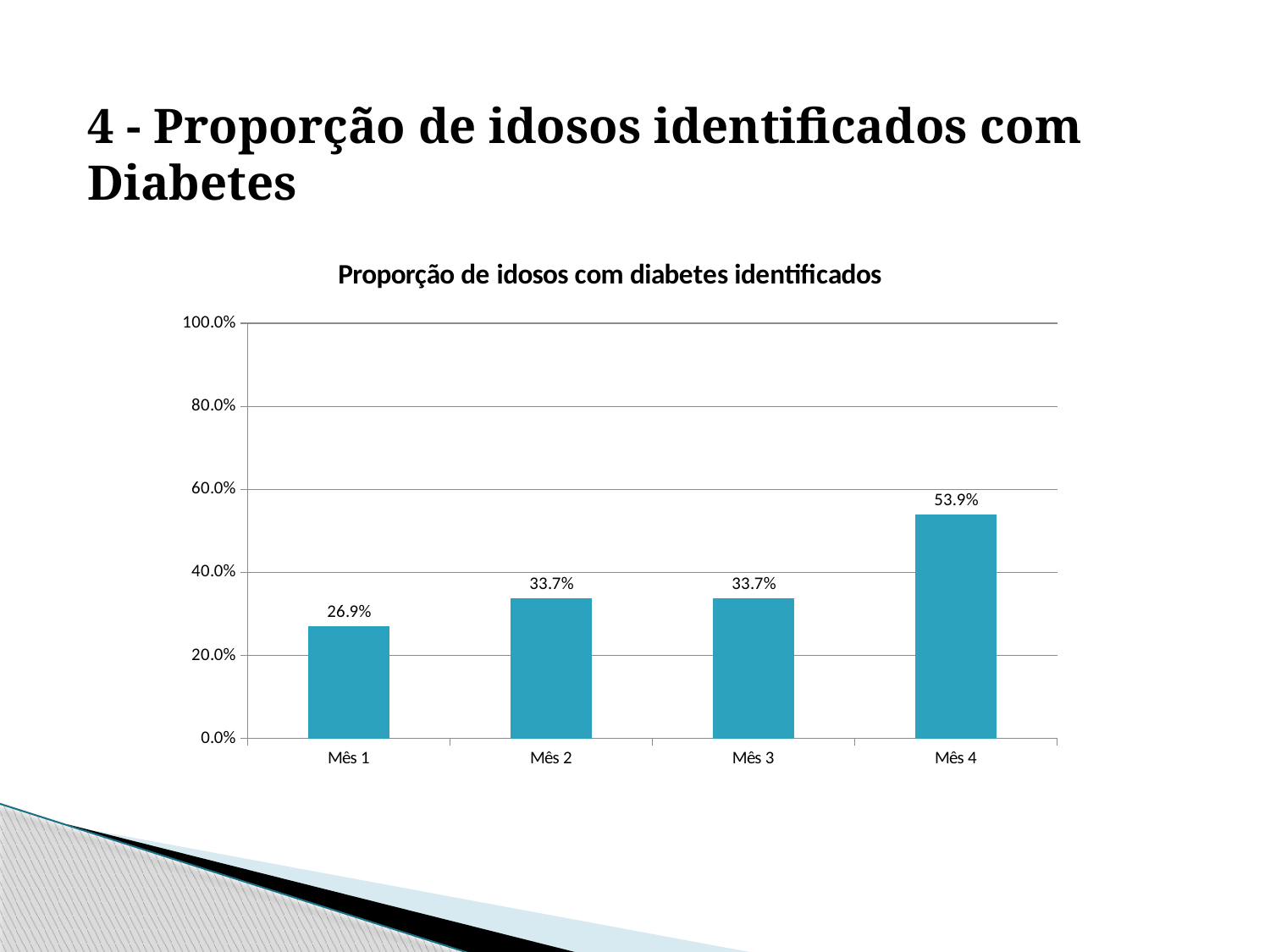
Which month has the highest proportion? Mês 4 What is the value for Mês 2? 33.7% How many months are shown on the x axis? 4 What is the value for Mês 1? 26.9% What kind of chart is shown on the slide? bar chart Which is larger, the value for Mês 3 or the value for Mês 4? Mês 4 What is the title of the chart? Proporção de idosos com diabetes identificados Which month has the lowest proportion? Mês 1 What is the value for Mês 4? 53.9% What is the difference between the values for Mês 2 and Mês 1? 6.8% Is the value for Mês 4 greater or less than 40.0%? greater What is the difference between the values for Mês 4 and Mês 1? 27.0%